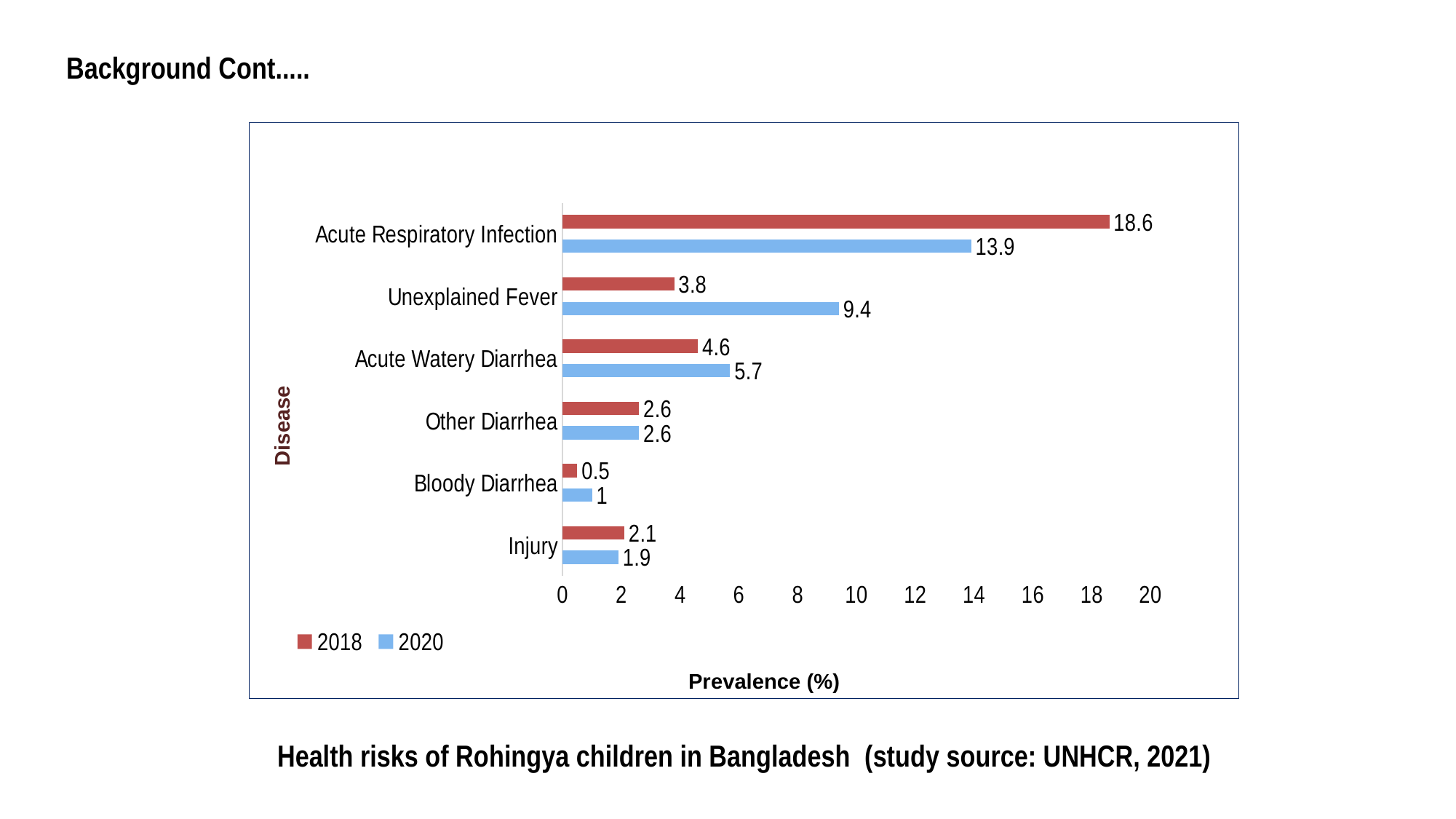
What is the 2020 prevalence for Unexplained Fever? 9.4 What is the difference between the 2018 and 2020 prevalence for Acute Respiratory Infection? 4.7 What kind of chart is shown on the slide? Bar chart What is the 2018 prevalence for Acute Respiratory Infection? 18.6 What is the difference between the 2020 and 2018 prevalence for Unexplained Fever? 5.6 How many diseases are shown on the chart? 6 Which disease has the lowest 2018 prevalence? Bloody Diarrhea Which disease has the highest 2020 prevalence? Acute Respiratory Infection What is the 2020 prevalence for Bloody Diarrhea? 1 Is the 2020 value for Acute Respiratory Infection greater or less than 12? greater Which is larger for Acute Watery Diarrhea, the 2018 value or the 2020 value? 2020 How many series does the legend list? 2